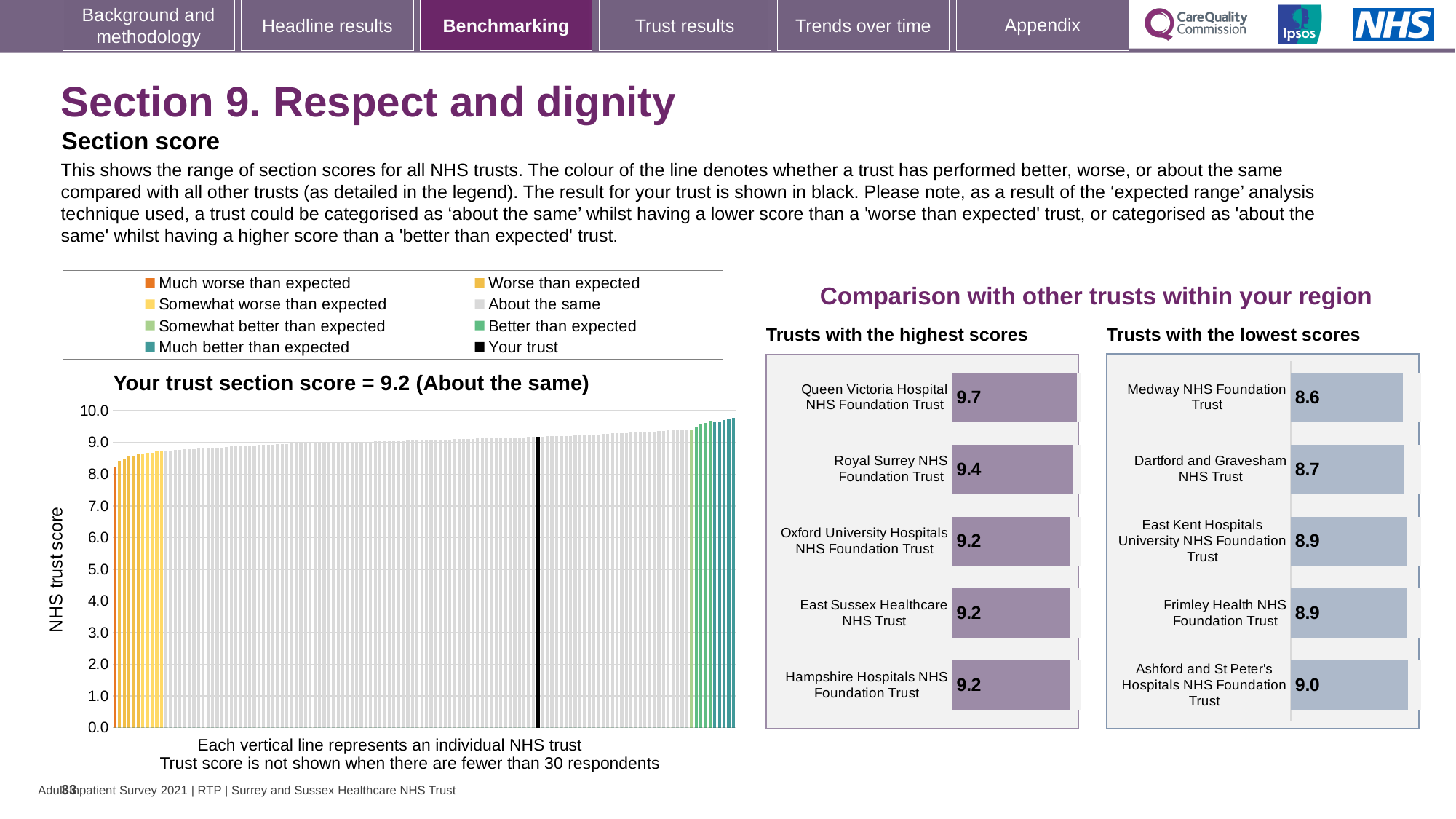
How many trusts are shown in the 'Trusts with the lowest scores' chart? 5 What kind of chart is the main chart on the left titled 'Your trust section score = 9.2 (About the same)'? Bar chart In the 'Trusts with the lowest scores' chart, which trust has the lowest score? Medway NHS Foundation Trust In the 'Trusts with the lowest scores' chart, what is the score for Ashford and St Peter's Hospitals NHS Foundation Trust? 9.0 In the 'Trusts with the lowest scores' chart, what is the score for Medway NHS Foundation Trust? 8.6 In the main chart on the left, do the trust scores rise or fall from left to right along the x axis? Rise In the 'Trusts with the highest scores' chart, what is the score for Royal Surrey NHS Foundation Trust? 9.4 In the 'Trusts with the lowest scores' chart, which has the larger score: Dartford and Gravesham NHS Trust or Ashford and St Peter's Hospitals NHS Foundation Trust? Ashford and St Peter's Hospitals NHS Foundation Trust In the 'Trusts with the highest scores' chart, what is the score for Queen Victoria Hospital NHS Foundation Trust? 9.7 According to the title of the main chart on the left, what is your trust's section score? 9.2 In the 'Trusts with the highest scores' chart, what is the difference between the scores of Queen Victoria Hospital NHS Foundation Trust and Royal Surrey NHS Foundation Trust? 0.3 In the 'Trusts with the highest scores' chart, which trust has the highest score? Queen Victoria Hospital NHS Foundation Trust